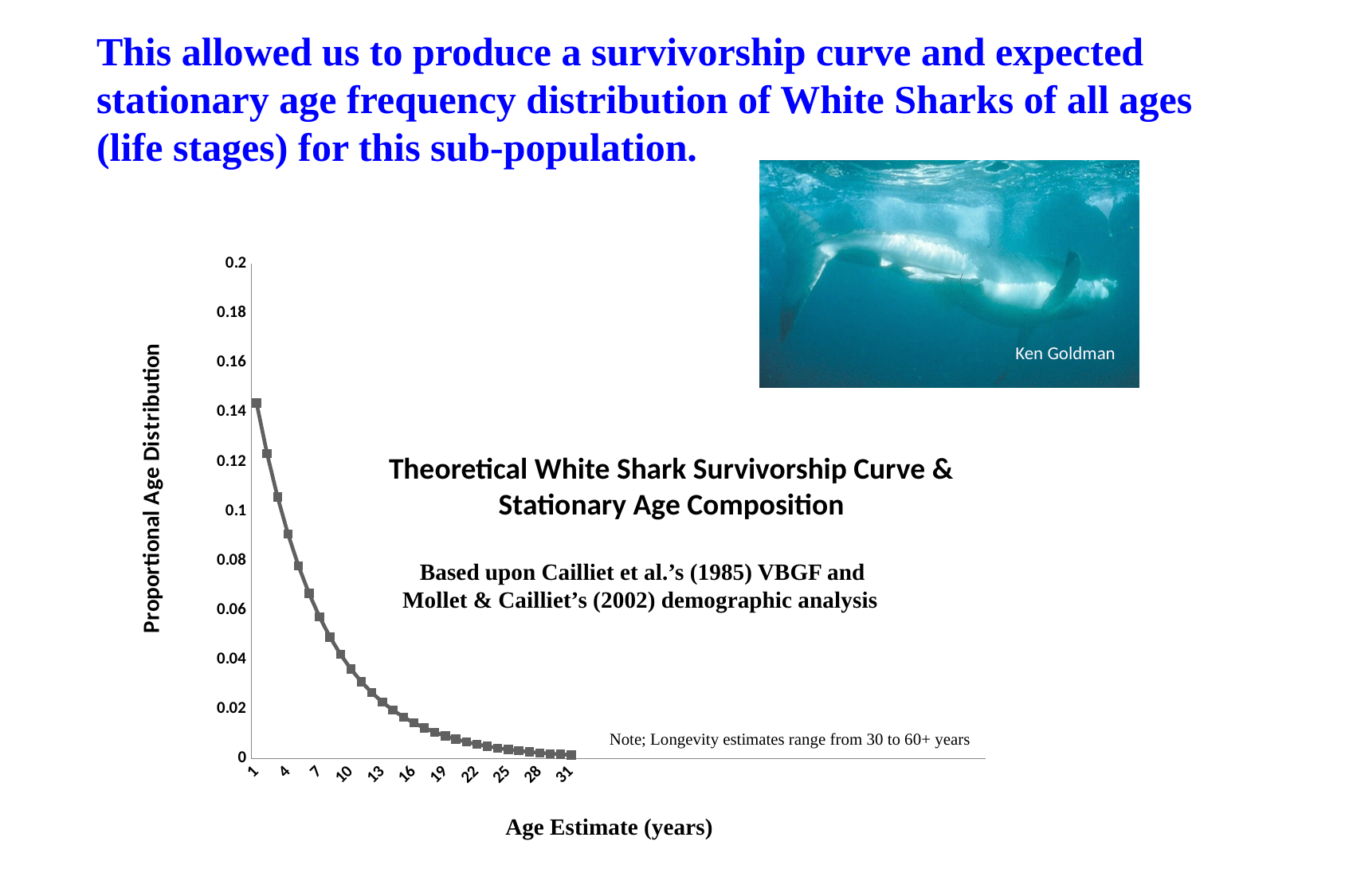
Which has the larger proportional age distribution, age 7 or age 22? age 7 How many age estimates are plotted on the curve? 31 Is the value at age 1 greater or less than 0.12? greater Is the value at age 10 greater or less than 0.06? less Do the values rise or fall as age increases along the x axis? fall At which age estimate is the proportional age distribution lowest? 31 At which age estimate is the proportional age distribution highest? 1 Is the value at age 19 greater or less than 0.02? less What kind of chart is shown on the slide? line chart What is the label of the y axis? Proportional Age Distribution What is the title of the chart? Theoretical White Shark Survivorship Curve & Stationary Age Composition